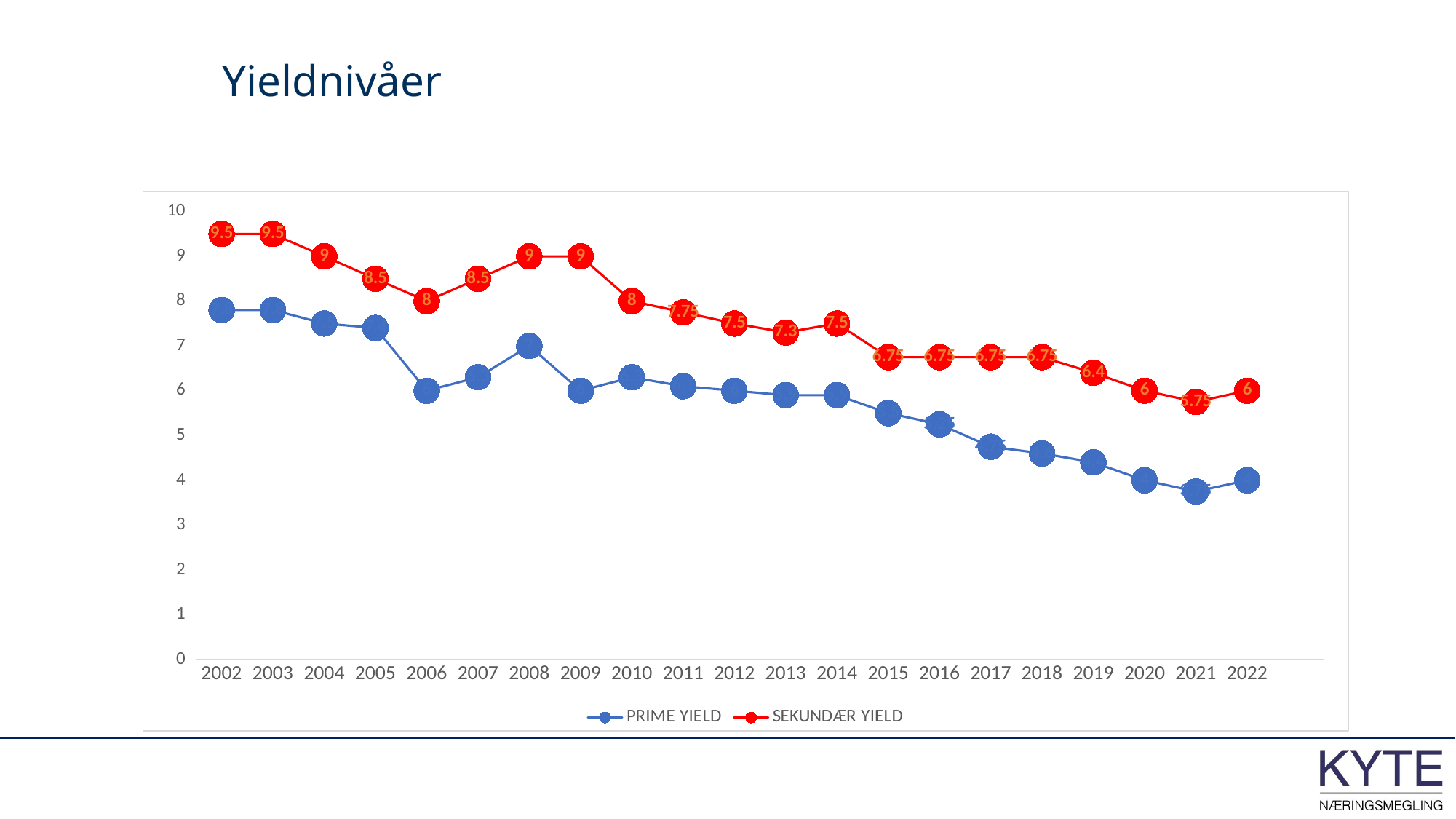
Which year has the higher SEKUNDÆR YIELD, 2013 or 2014? 2014 What is the SEKUNDÆR YIELD value for 2013? 7.3 What is the SEKUNDÆR YIELD value for 2011? 7.75 Is the PRIME YIELD value for 2021 greater or less than 5? less What is the SEKUNDÆR YIELD value for 2019? 6.4 In which year is the SEKUNDÆR YIELD at its lowest? 2021 Is the PRIME YIELD value for 2002 greater or less than 7? greater What is the difference between the SEKUNDÆR YIELD in 2002 and in 2022? 3.5 Does the PRIME YIELD generally rise or fall from 2002 to 2022? Fall How many years are shown on the x axis? 21 What type of chart is shown on the slide? Line chart How many series does the legend list? 2